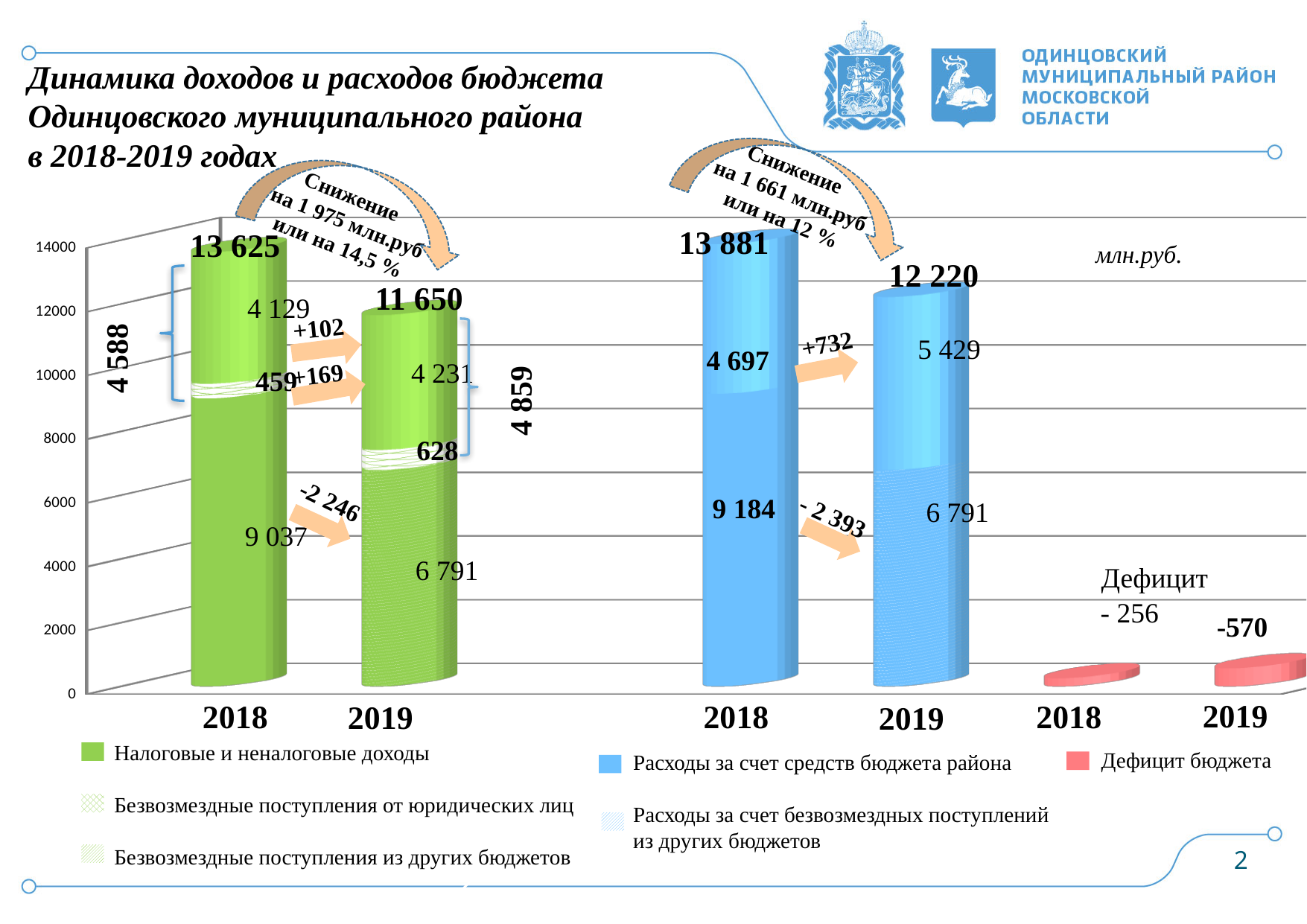
What colour represents 'Дефицит бюджета' in the legend? Red What type of chart is shown on the slide? Bar chart What is the value of 'Расходы за счет средств бюджета района' in 2018? 9 184 What is the value of 'Налоговые и неналоговые доходы' in 2018? 9 037 Do total budget incomes rise or fall from 2018 to 2019? Fall Which is larger: total income in 2018 (13 625) or total expenditure in 2018 (13 881)? Total expenditure in 2018 (13 881) What is the total budget income (доходы) for 2019 shown on the chart? 11 650 What is the total budget income (доходы) for 2018 shown on the chart? 13 625 What unit of measurement is indicated on the chart? млн.руб. What is the total budget expenditure (расходы) for 2019 shown on the chart? 12 220 By how much did total budget expenditure fall from 2018 (13 881) to 2019 (12 220)? 1 661 What is the budget deficit (Дефицит бюджета) for 2019? -570